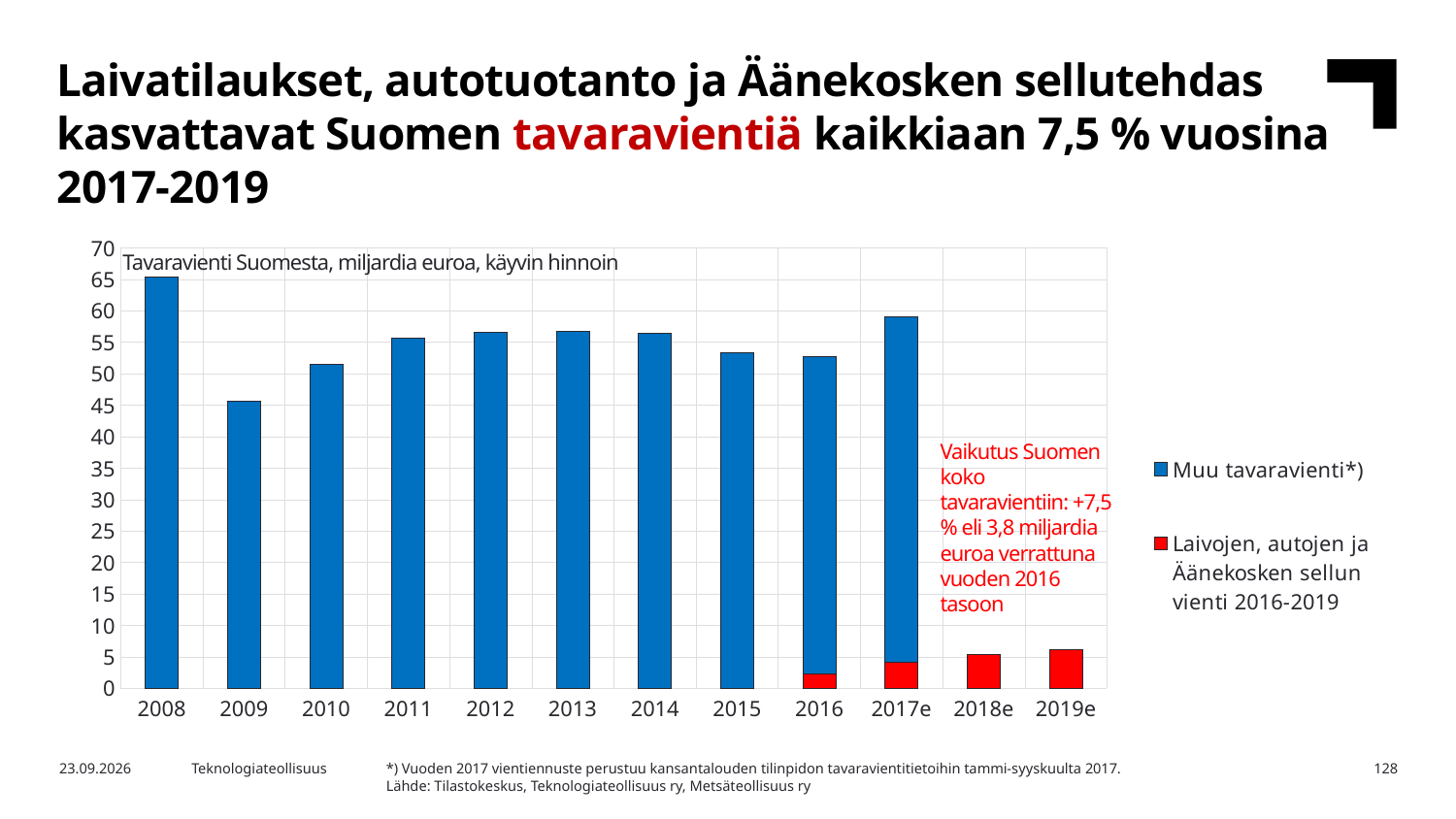
Does the total goods export value rise or fall from 2008 to 2009? Fall Which year has a larger total bar, 2012 or 2009? 2012 Is the total value for 2008 greater or less than 60? greater Is the total value for 2017e greater or less than 55? greater Is the red 'Laivojen, autojen ja Äänekosken sellun vienti 2016-2019' value for 2019e greater or less than 5? greater How many series does the chart legend list? 2 What is the title text shown inside the chart area? Tavaravienti Suomesta, miljardia euroa, käyvin hinnoin Which year has the highest total goods export bar in the chart? 2008 What kind of chart is shown on the slide? Stacked bar chart Among the years 2008 to 2017e, which year has the lowest total bar? 2009 How many years (categories) are shown on the x axis of the chart? 12